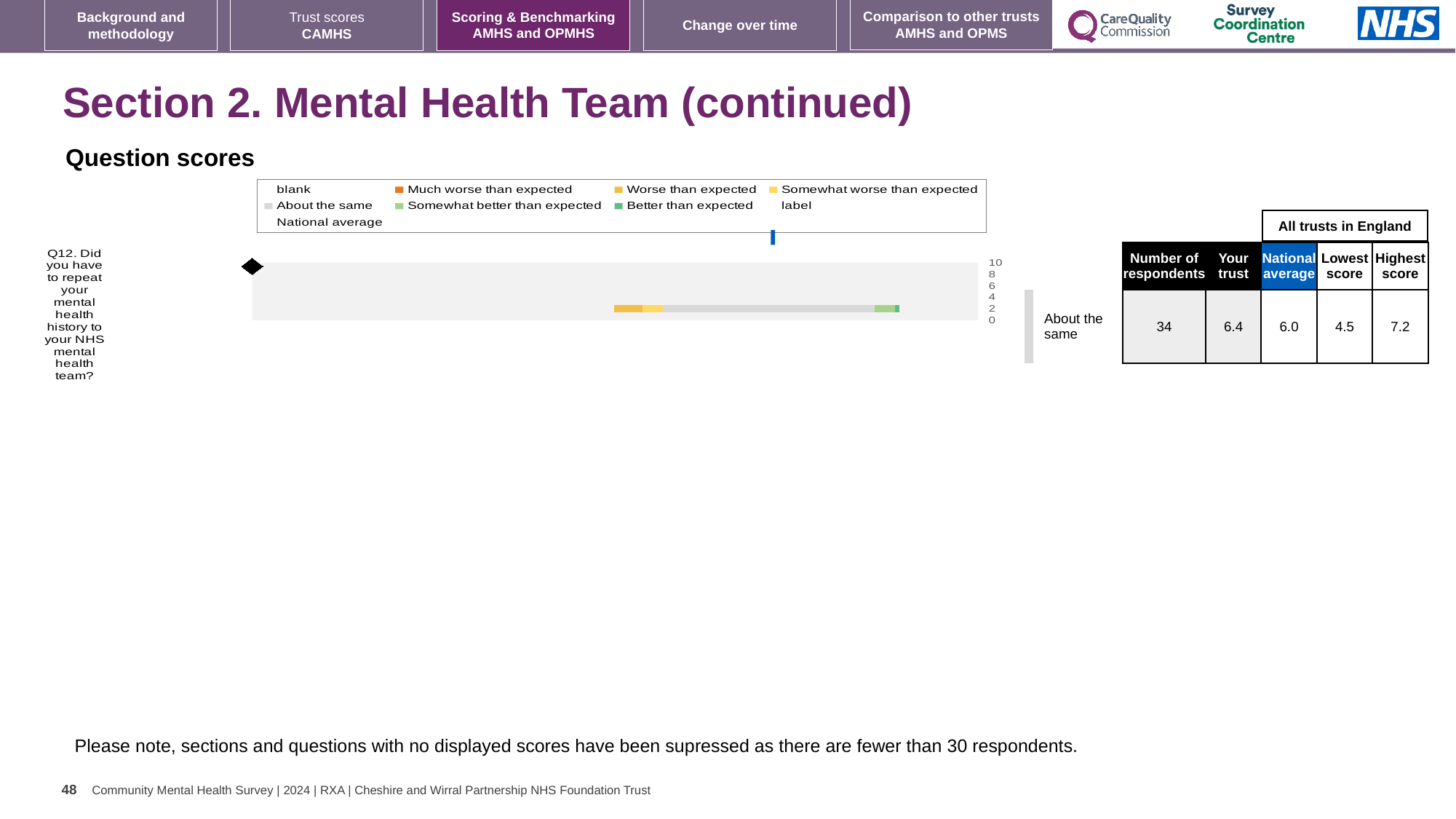
For Q12, which is larger: the 'Your trust' score or the national average? Your trust What is the highest score among all trusts in England for Q12? 7.2 What kind of chart is used to show the question scores on this slide? bar chart What is the lowest score among all trusts in England for Q12? 4.5 What benchmark category is given for Q12 next to the chart? About the same Which question is plotted in the question scores chart? Q12. Did you have to repeat your mental health history to your NHS mental health team? What is the 'Your trust' score for Q12 in the table beside the chart? 6.4 For Q12, what is the difference between the 'Your trust' score and the national average? 0.4 How many respondents answered Q12 according to the table beside the chart? 34 How many survey questions are plotted in the question scores chart? 1 What is the maximum value shown on the score axis of the question scores chart? 10 What is the national average score for Q12 in the table beside the chart? 6.0